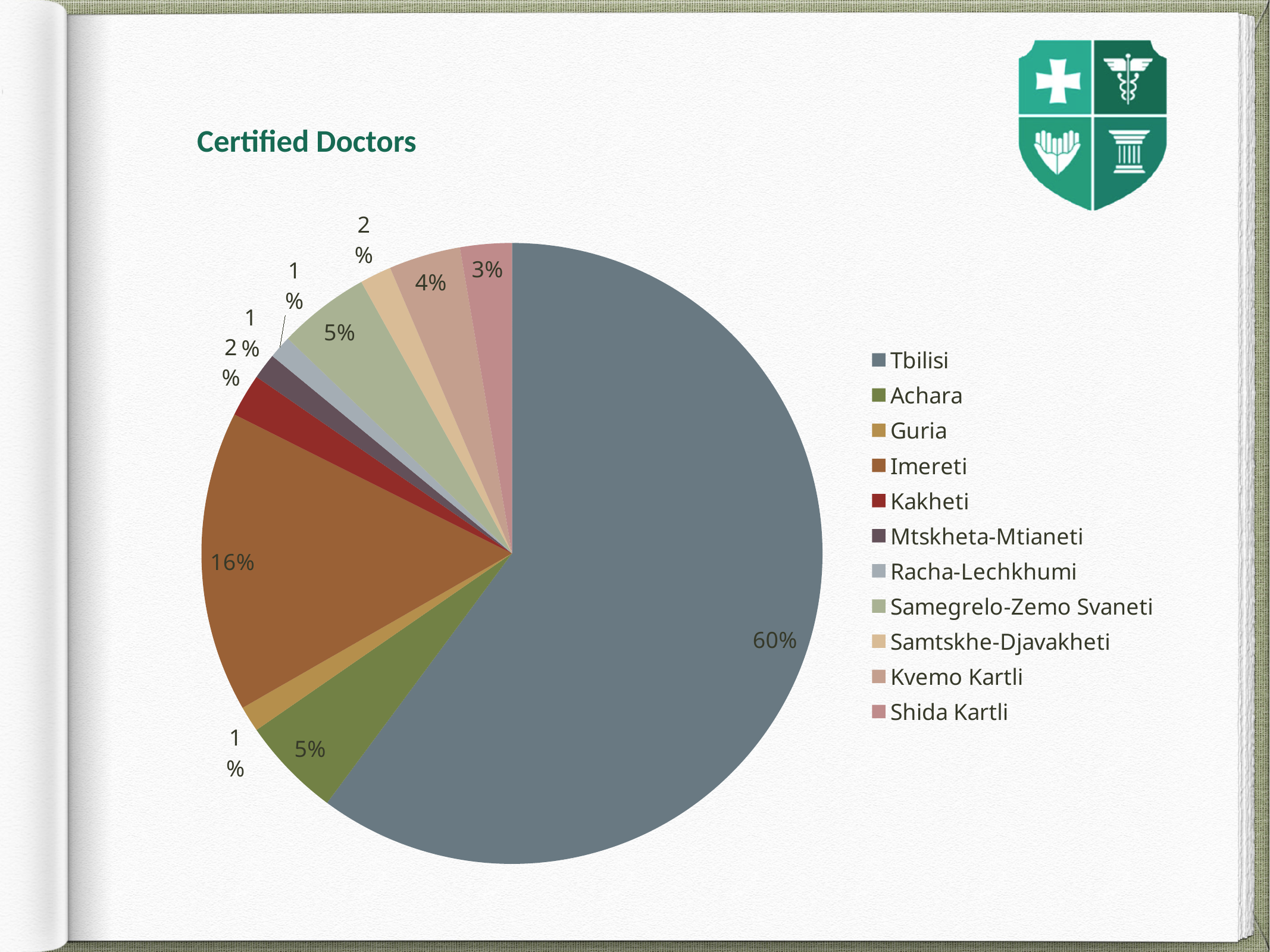
How many regions are listed in the legend? 11 Which region has the largest share of certified doctors? Tbilisi Which has a larger share, Imereti or Achara? Imereti What share of certified doctors is in Shida Kartli? 3% What share of certified doctors is in Kvemo Kartli? 4% What kind of chart is shown on the slide? pie chart What is the difference in percentage points between the Tbilisi and Imereti shares? 44 What is the title of the chart? Certified Doctors What share of certified doctors is in Imereti? 16% Which has a larger share, Kvemo Kartli or Shida Kartli? Kvemo Kartli